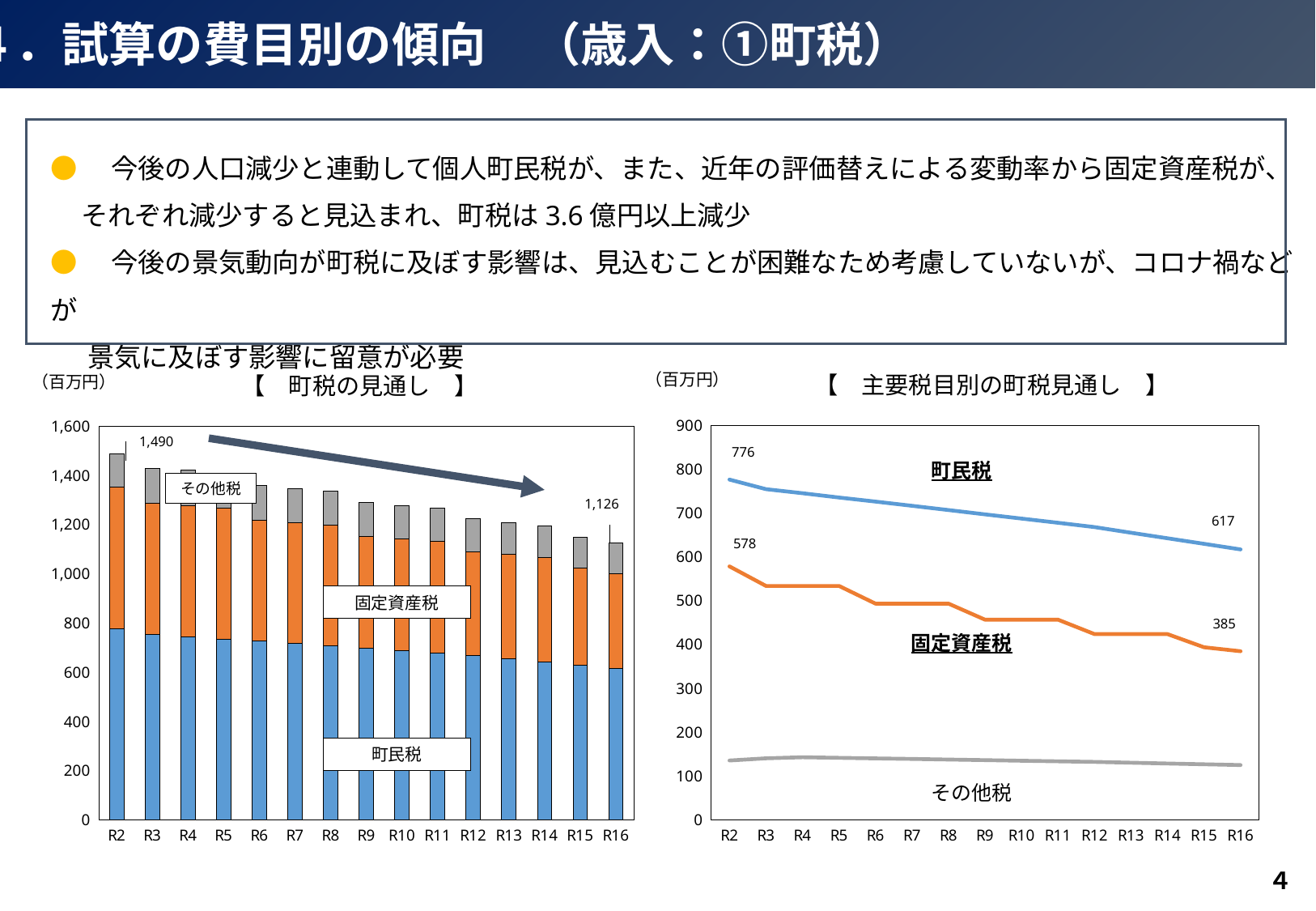
In the right chart 【主要税目別の町税見通し】, is the value of その他税 in R2 greater or less than 200? less In the right chart 【主要税目別の町税見通し】, by how much does 町民税 decrease from R2 (776) to R16 (617)? 159 In the right chart 【主要税目別の町税見通し】, what is the value of 固定資産税 in R16? 385 In the left chart 【町税の見通し】, what is the total value labelled for R2? 1,490 In the left chart 【町税の見通し】, is the 町民税 segment for R2 greater or less than 600? greater In the left chart 【町税の見通し】, do the total bar heights rise or fall from R2 to R16? Fall In the left chart 【町税の見通し】, what is the difference between the R2 total (1,490) and the R16 total (1,126)? 364 In the right chart 【主要税目別の町税見通し】, which line is the lowest across all years? その他税 In the left chart 【町税の見通し】, how many years are shown on the x axis? 15 What kind of chart is the left chart 【町税の見通し】? Stacked bar chart In the right chart 【主要税目別の町税見通し】, what is the value of 町民税 in R2? 776 In the left chart 【町税の見通し】, what is the total value labelled for R16? 1,126